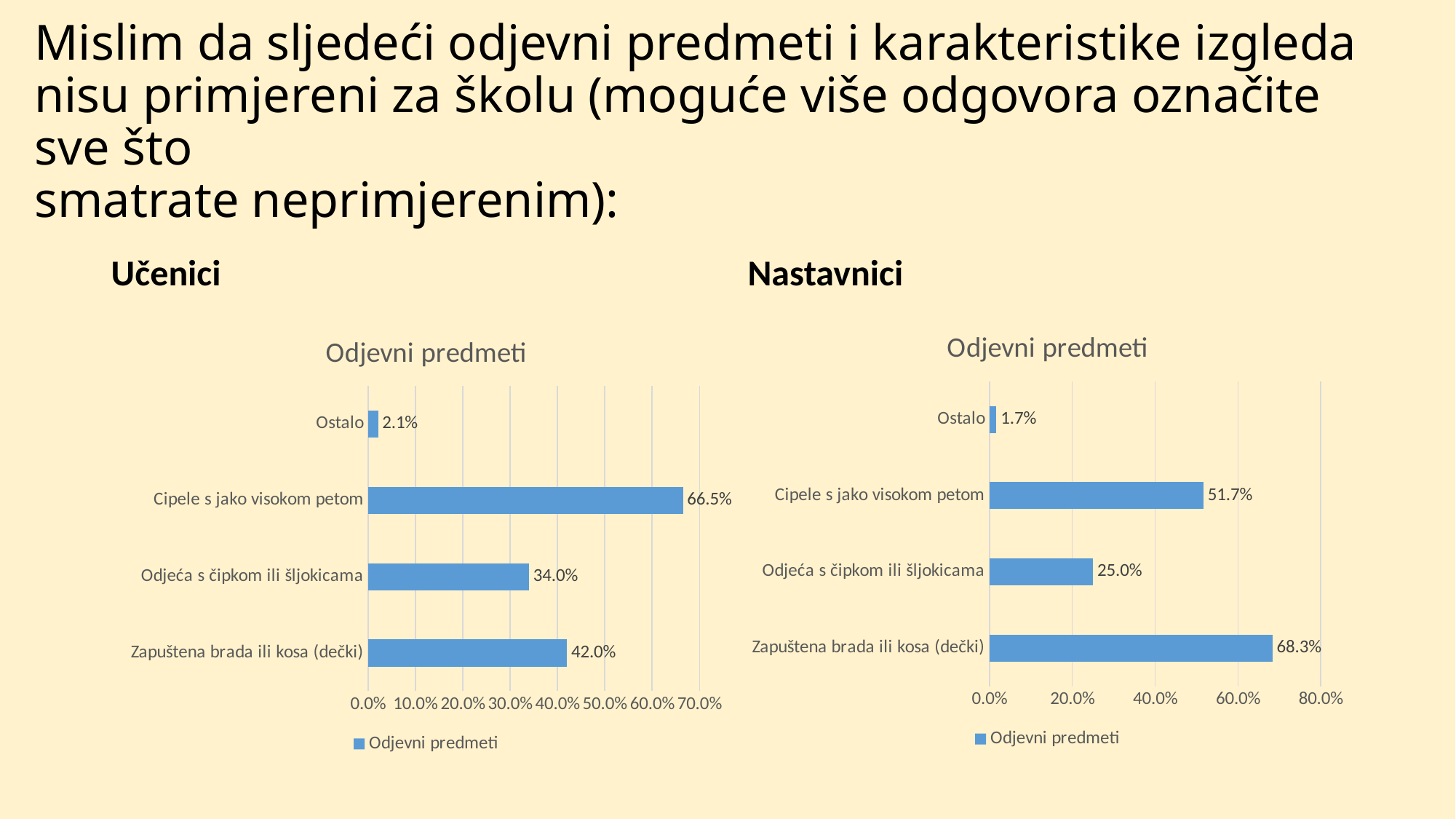
Which is larger in the Učenici chart: Zapuštena brada ili kosa (dečki) or Odjeća s čipkom ili šljokicama? Zapuštena brada ili kosa (dečki) In the Nastavnici chart, what is the value for Zapuštena brada ili kosa (dečki)? 68.3% In the Nastavnici chart, what is the value for Odjeća s čipkom ili šljokicama? 25.0% In the Nastavnici chart, which category has the lowest value? Ostalo In the Nastavnici chart, is the value for Cipele s jako visokom petom greater or less than 40.0%? greater How many categories are shown in the Učenici chart? 4 In the Učenici chart, what is the value for Cipele s jako visokom petom? 66.5% In the Učenici chart, which category has the highest value? Cipele s jako visokom petom What is the title of the Učenici chart? Odjevni predmeti What kind of chart is the Nastavnici chart? bar chart In the Učenici chart, what is the difference between Zapuštena brada ili kosa (dečki) and Odjeća s čipkom ili šljokicama? 8.0% In the Nastavnici chart, what is the difference between Zapuštena brada ili kosa (dečki) and Cipele s jako visokom petom? 16.6%